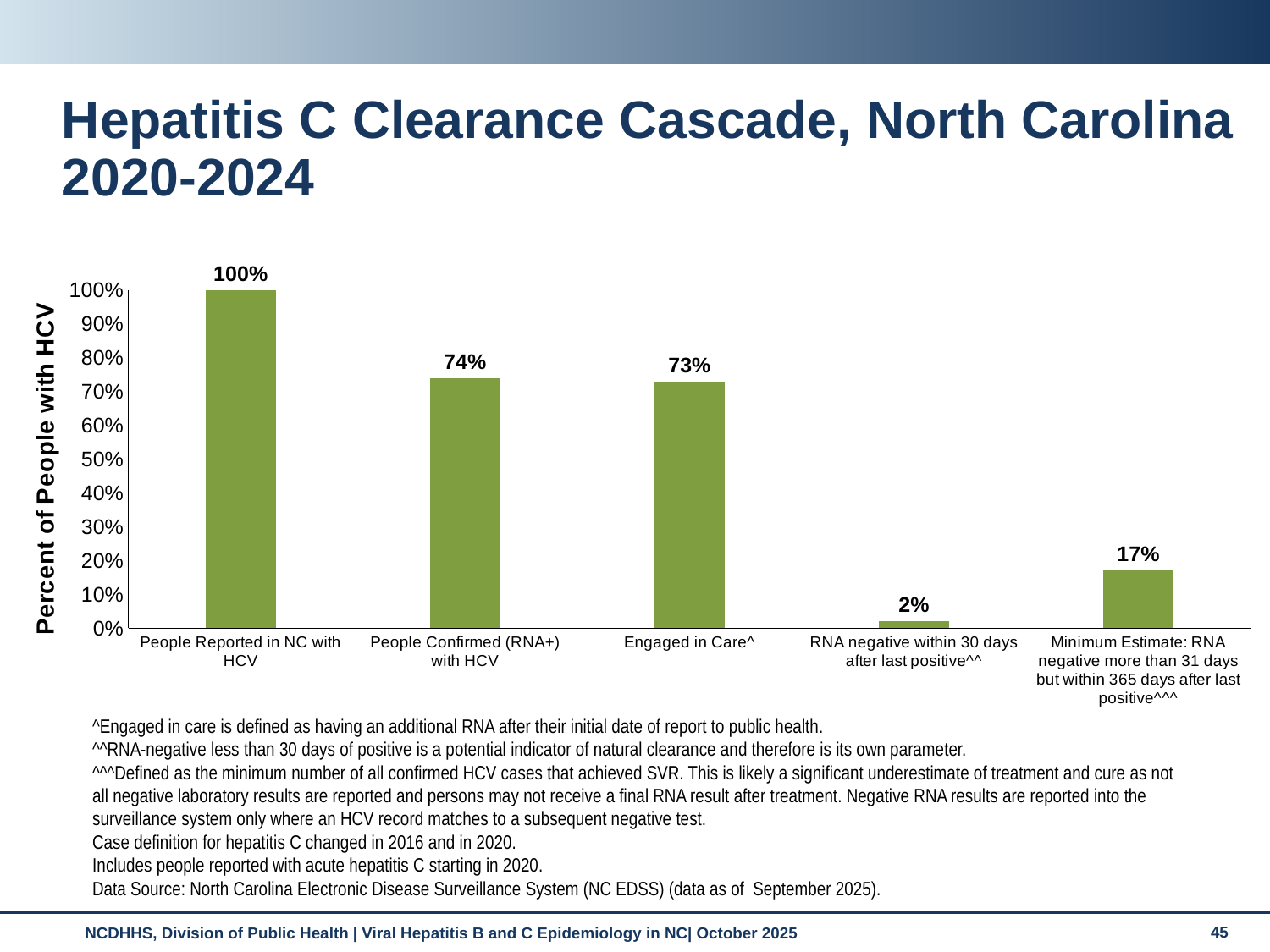
What is the difference between the Minimum Estimate: RNA negative more than 31 days but within 365 days after last positive^^^ bar and the RNA negative within 30 days after last positive^^ bar? 15% Which is larger: the value for Engaged in Care^ or the value for the Minimum Estimate: RNA negative more than 31 days but within 365 days after last positive^^^? Engaged in Care^ Which category has the highest value? People Reported in NC with HCV Which category has the lowest value? RNA negative within 30 days after last positive^^ What is the label of the y axis? Percent of People with HCV What is the value for the Minimum Estimate: RNA negative more than 31 days but within 365 days after last positive^^^ bar? 17% What is the difference between People Confirmed (RNA+) with HCV and Engaged in Care^? 1% What percentage of people with HCV were confirmed (RNA+) with HCV? 74% How many categories are shown on the x axis? 5 What kind of chart is shown on the slide? Bar chart What percentage were RNA negative within 30 days after last positive^^? 2% What is the value for Engaged in Care^? 73%